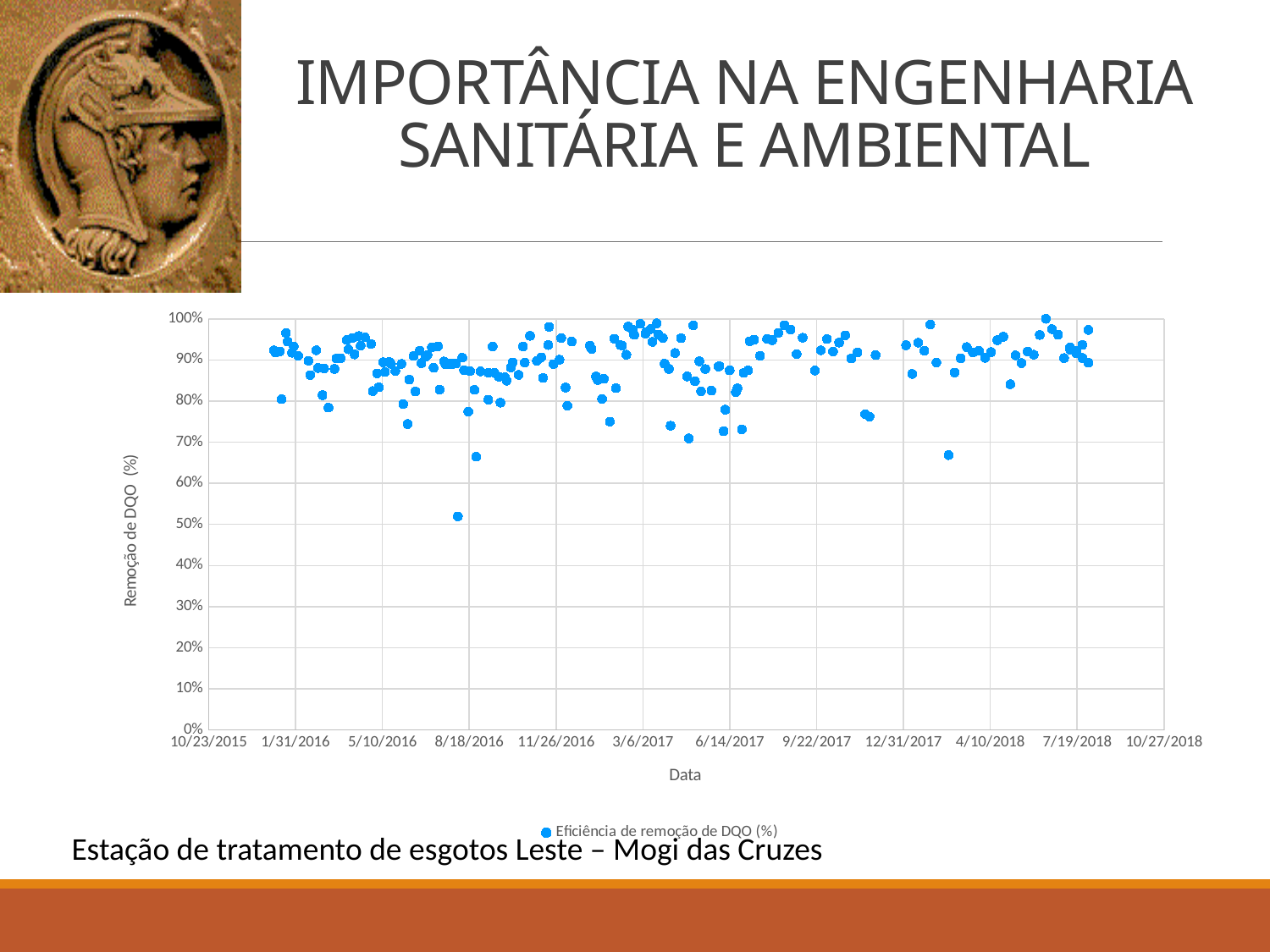
Is the lowest plotted value on the chart greater or less than 60%? less Is the lowest plotted value on the chart greater or less than 40%? greater What is the maximum value shown on the vertical axis of the chart? 100% What is the legend entry for the plotted series? Eficiência de remoção de DQO (%) How many series does the chart legend list? 1 What kind of chart is shown on the slide? Scatter chart What is the title of the vertical axis of the chart? Remoção de DQO (%) Is the highest plotted value on the chart greater or less than 90%? greater